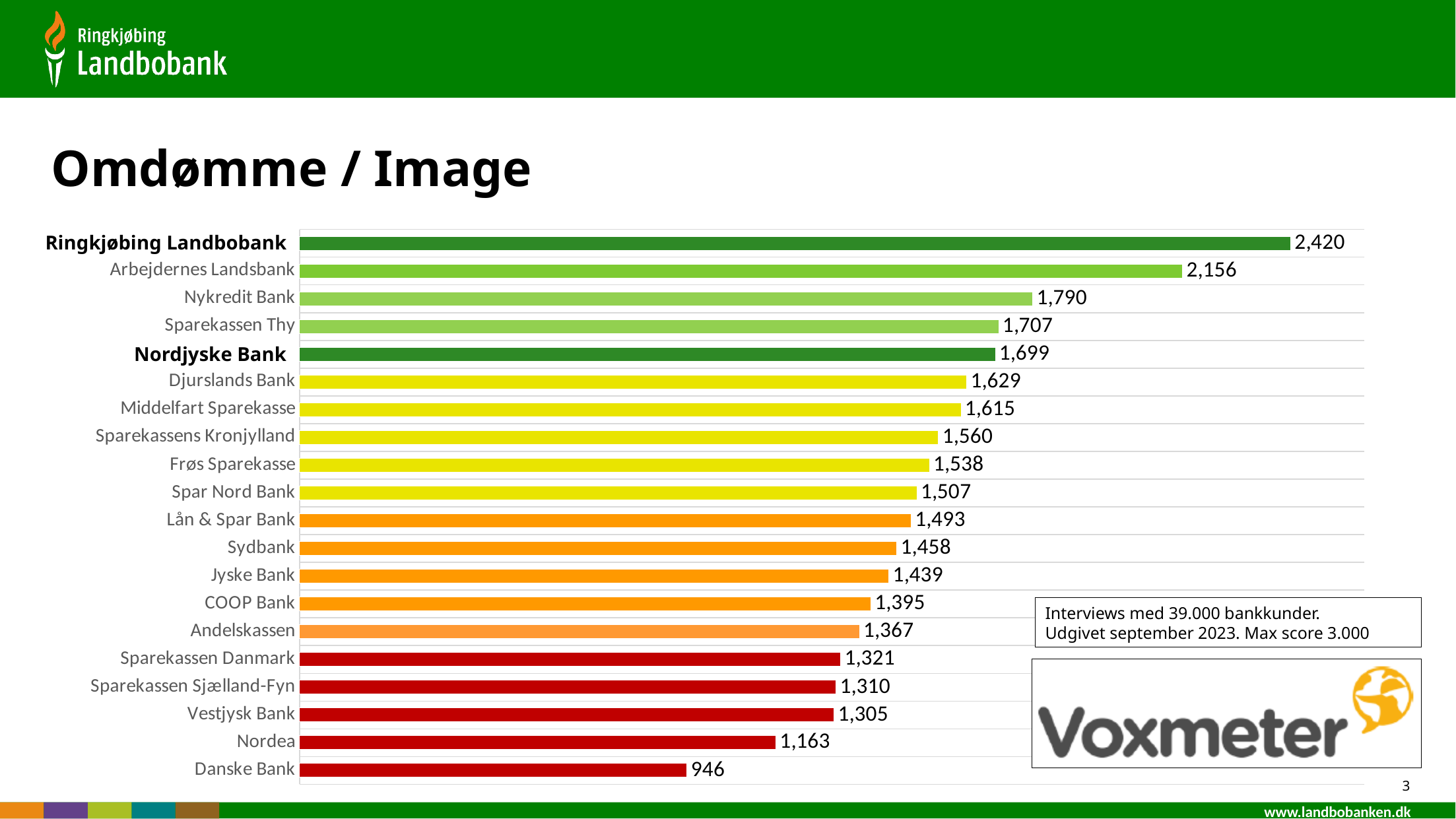
What is the value for Sydbank? 1,458 What is the value for Danske Bank? 946 What is the value for Ringkjøbing Landbobank? 2,420 Which has a larger value, Nykredit Bank or Sparekassen Thy? Nykredit Bank What kind of chart is shown on the slide? Bar chart What is the difference between the values for Nordea and Danske Bank? 217 Which bank has the lowest value? Danske Bank What is the title of the slide? Omdømme / Image What is the value for Nordjyske Bank? 1,699 What is the difference between the values for Ringkjøbing Landbobank and Arbejdernes Landsbank? 264 Which bank has the highest value? Ringkjøbing Landbobank How many banks are shown in the chart? 20